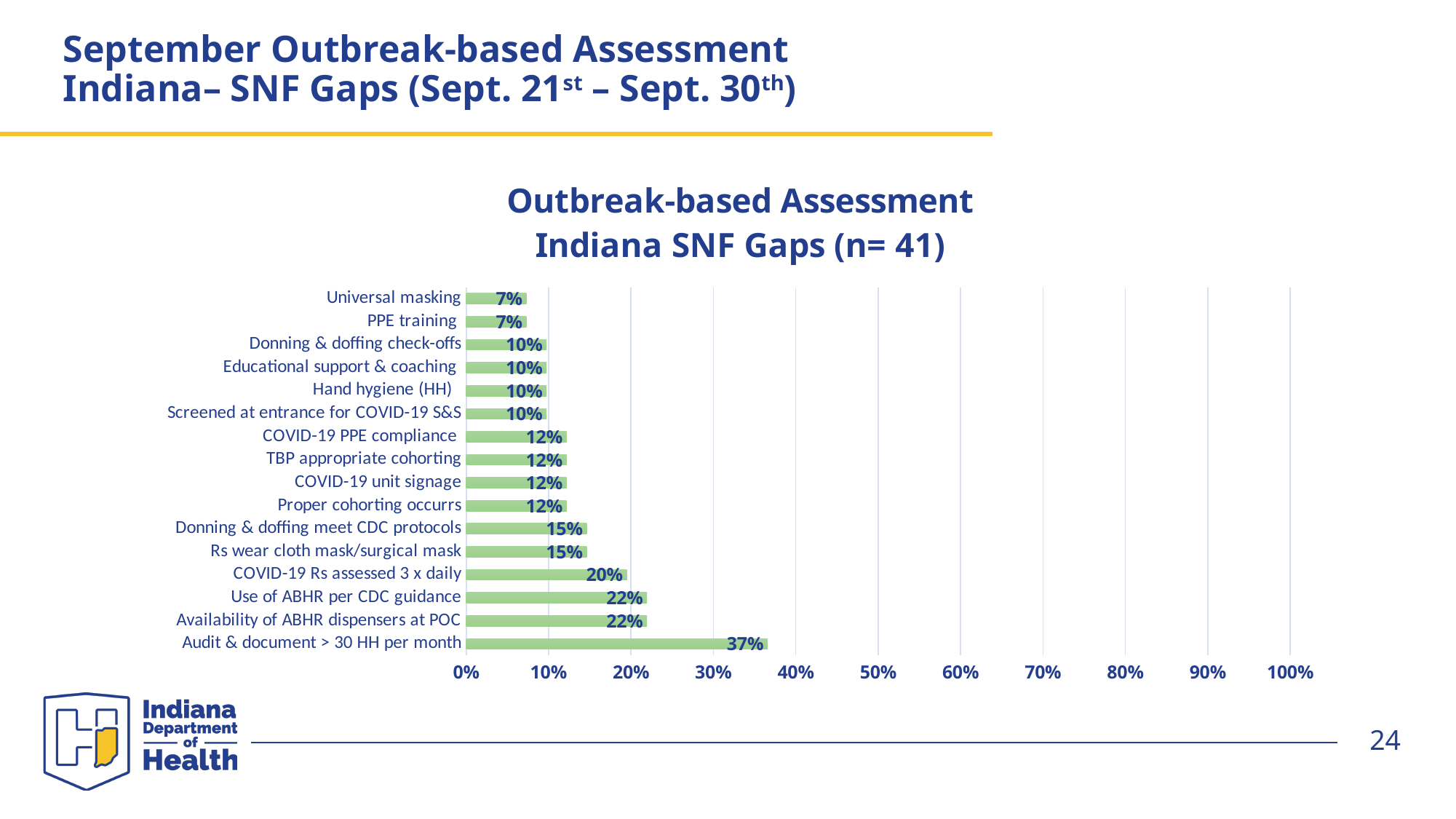
Is the value for Audit & document > 30 HH per month greater or less than 30%? greater What is the value for Universal masking? 7% What is the value for Audit & document > 30 HH per month? 37% What is the sample size (n) given in the chart title? 41 What is the value for COVID-19 Rs assessed 3 x daily? 20% What kind of chart is shown on the slide? bar chart How many categories are shown in the chart? 16 What is the difference between the values for Audit & document > 30 HH per month and Use of ABHR per CDC guidance? 15% Which category has the highest value? Audit & document > 30 HH per month Which is larger, the value for Rs wear cloth mask/surgical mask or the value for COVID-19 unit signage? Rs wear cloth mask/surgical mask What is the difference between the values for COVID-19 Rs assessed 3 x daily and PPE training? 13% What is the value for Hand hygiene (HH)? 10%